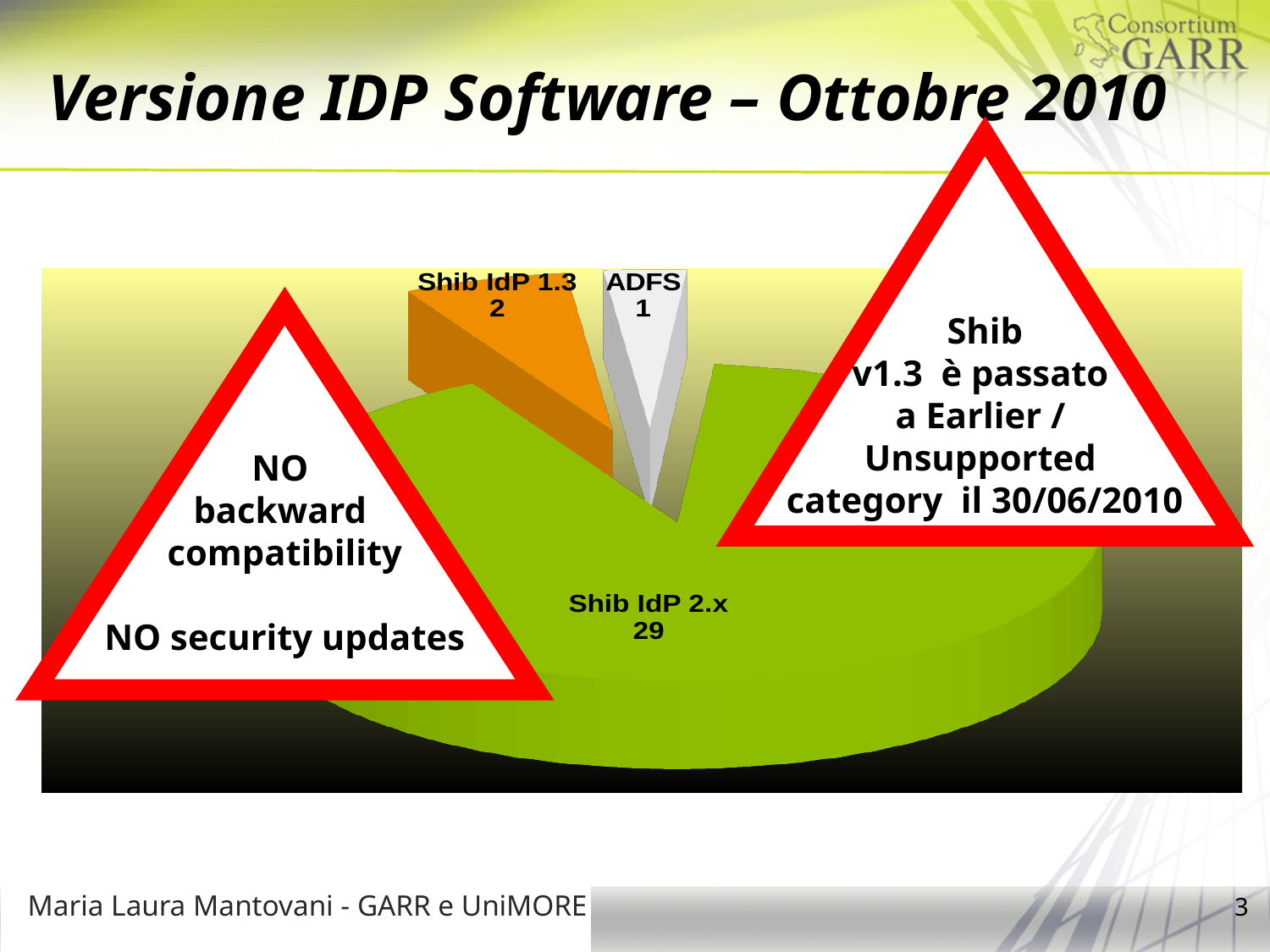
What is the value for ADFS in the pie chart? 1 Which category has the largest slice in the pie chart? Shib IdP 2.x What is the total of all slices in the pie chart? 32 Which is larger, the value for Shib IdP 1.3 or the value for ADFS? Shib IdP 1.3 Which category has the smallest slice in the pie chart? ADFS What is the title of the slide containing the pie chart? Versione IDP Software – Ottobre 2010 What kind of chart is shown on the slide? pie chart How many slices does the pie chart have? 3 What is the difference between the values for Shib IdP 2.x and Shib IdP 1.3? 27 What share of the pie does the Shib IdP 1.3 slice represent? 6.25% What is the value for Shib IdP 2.x in the pie chart? 29 What is the value for Shib IdP 1.3 in the pie chart? 2